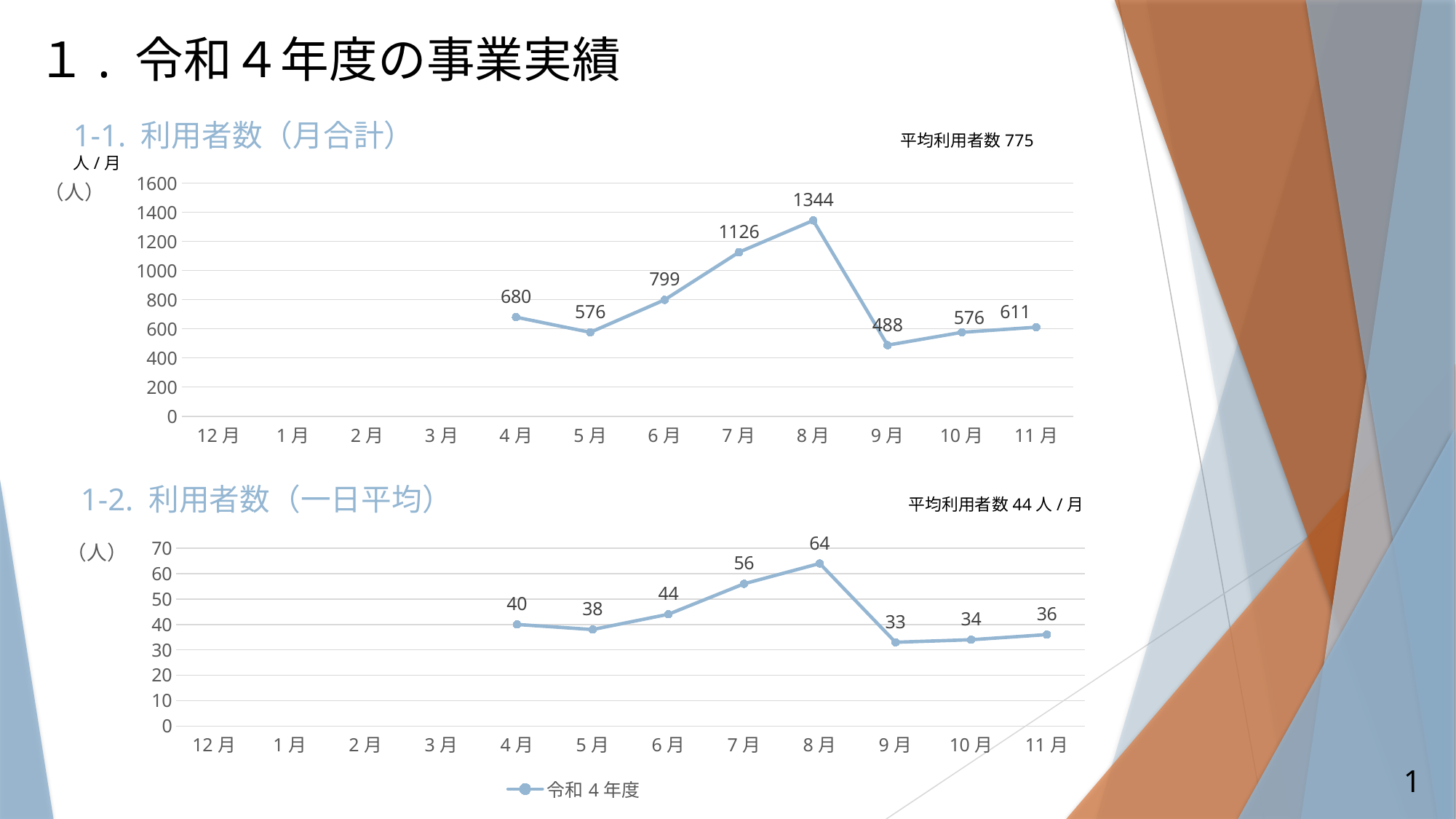
In the bottom chart (1-2. 利用者数（一日平均）), what is the difference between the values for 8月 and 9月? 31 In the top chart (1-1. 利用者数（月合計）), which month has the highest value? 8月 In the top chart (1-1. 利用者数（月合計）), which month has the lowest plotted value? 9月 In the top chart (1-1. 利用者数（月合計）), what is the value for 9月? 488 In the top chart (1-1. 利用者数（月合計）), which is larger, the value for 4月 or the value for 11月? 4月 In the bottom chart (1-2. 利用者数（一日平均）), which month has the lowest plotted value? 9月 In the top chart (1-1. 利用者数（月合計）), what is the value for 8月? 1344 What kind of chart is the bottom chart (1-2. 利用者数（一日平均）)? Line chart In the bottom chart (1-2. 利用者数（一日平均）), what is the value for 7月? 56 In the bottom chart (1-2. 利用者数（一日平均）), what series name does the legend show? 令和４年度 In the top chart (1-1. 利用者数（月合計）), how many months have a plotted data point? 8 In the top chart (1-1. 利用者数（月合計）), what is the difference between the values for 8月 and 7月? 218